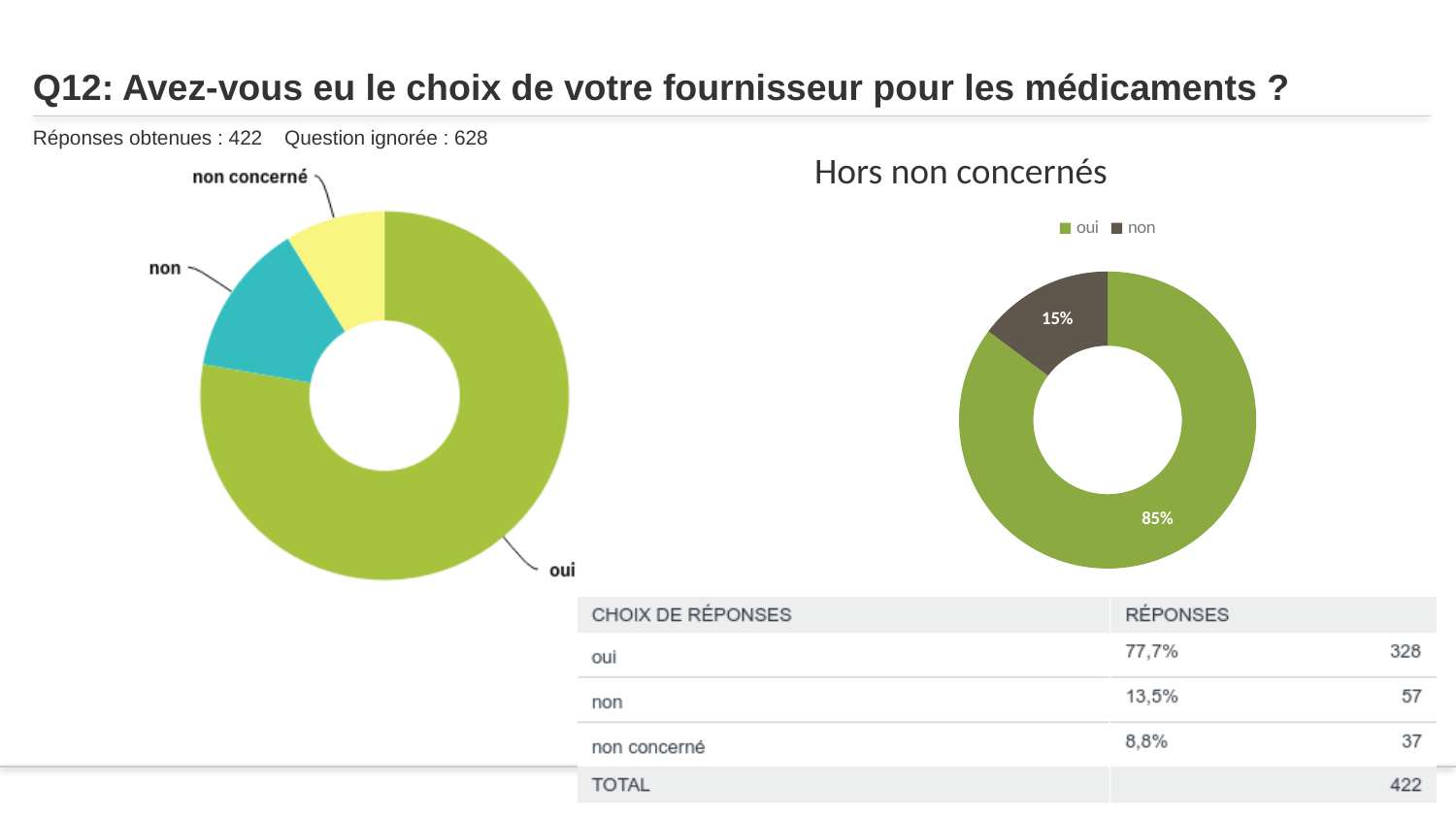
According to the table, what percentage of responses is 'non concerné'? 8,8% How many categories does the left donut chart show? 3 In the 'Hors non concernés' chart, what is the share for 'non'? 15% What is the total number of responses shown in the table? 422 In the 'Hors non concernés' chart, what is the difference between the 'oui' and 'non' shares? 70% According to the table, what percentage of responses is 'oui'? 77,7% In the left donut chart, which category has the largest slice? oui What kind of chart is the left chart on the slide? donut (pie) chart In the left donut chart, which category has the smallest slice? non concerné According to the table, how many responses are 'non'? 57 How many entries does the legend of the 'Hors non concernés' chart list? 2 In the 'Hors non concernés' chart, what is the share for 'oui'? 85%